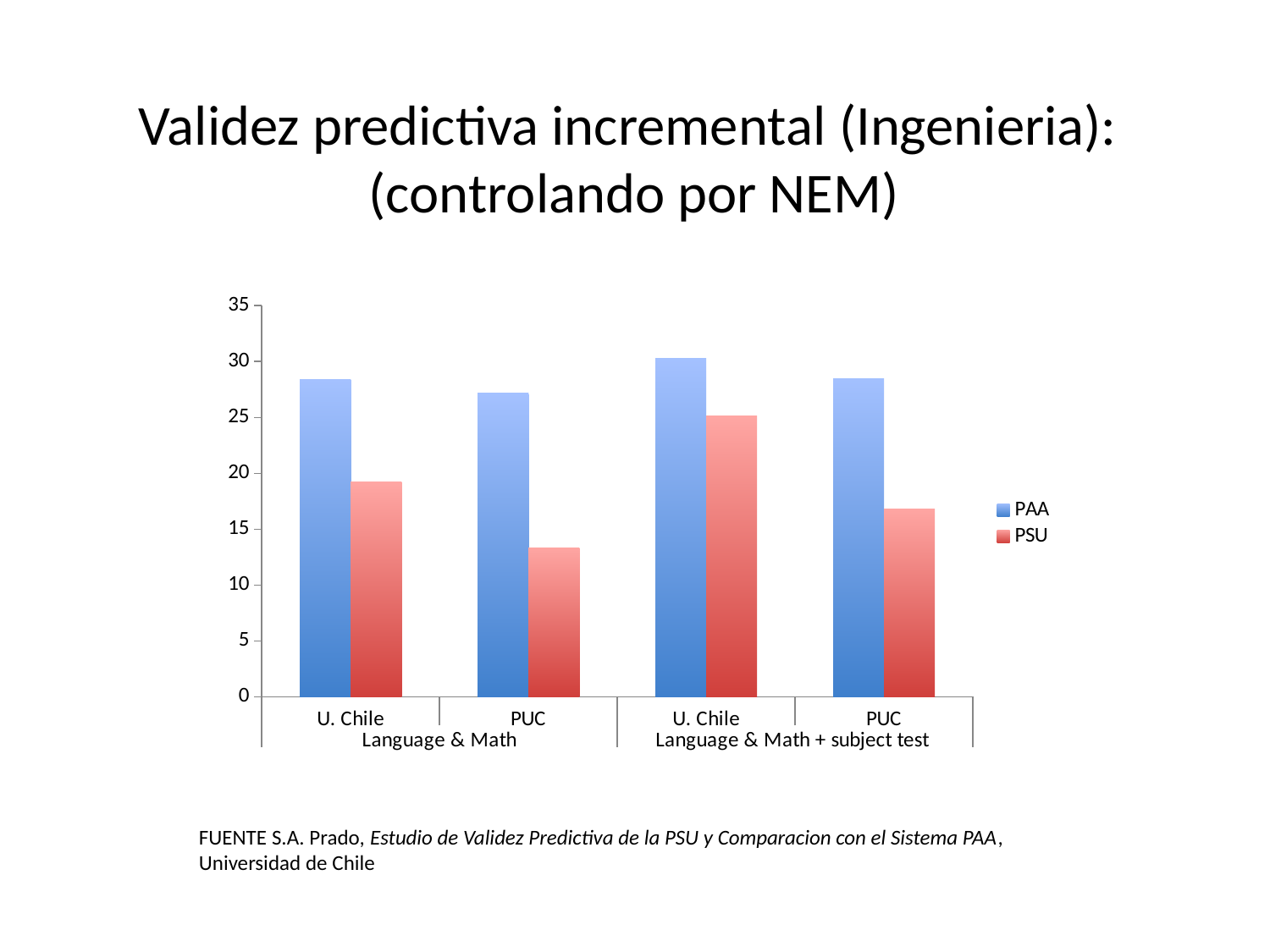
Is the PAA value for PUC under Language & Math greater or less than 25? greater How many categories (pairs of bars) are plotted along the x axis? 4 What kind of chart is shown on the slide? bar chart For PUC under Language & Math, which is larger, PAA or PSU? PAA Which category has the highest PSU value? U. Chile (Language & Math + subject test) Which category has the lowest PSU value? PUC (Language & Math) Is the PSU value for PUC under Language & Math + subject test greater or less than 20? less Which is larger, the PSU value for U. Chile under Language & Math or the PSU value for PUC under Language & Math + subject test? U. Chile under Language & Math What are the two series named in the legend? PAA and PSU Is the PSU value for PUC under Language & Math greater or less than 15? less Which category has the highest PAA value? U. Chile (Language & Math + subject test) How many series does the legend list? 2